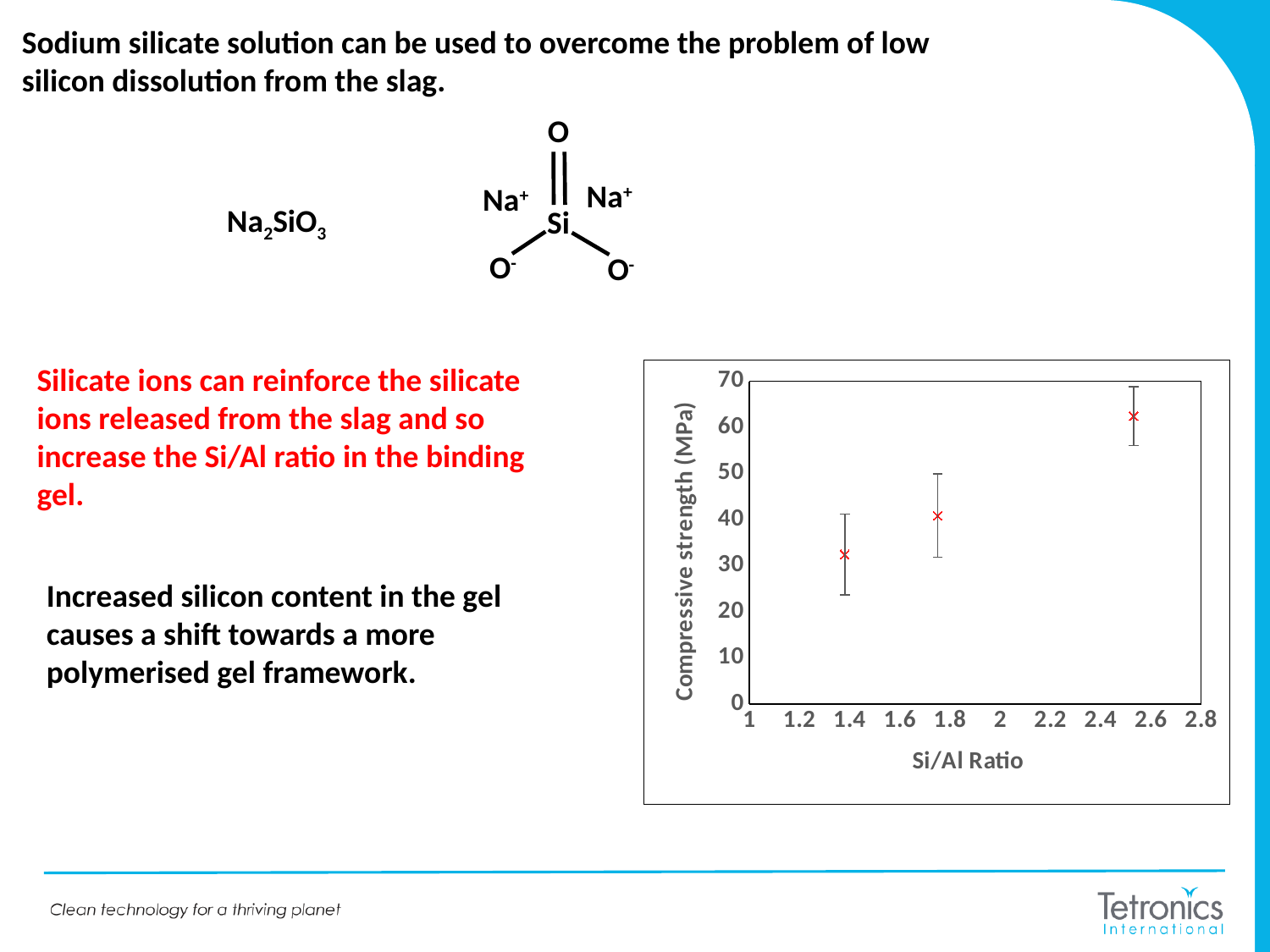
How many data points are plotted on the chart? 3 Is the compressive strength of the point with the highest Si/Al ratio greater or less than 70? less Which point has the highest compressive strength: the one with the lowest Si/Al ratio or the one with the highest Si/Al ratio? the one with the highest Si/Al ratio What is the maximum value shown on the y axis of the chart? 70 What is the title of the x axis of the chart? Si/Al Ratio Is the compressive strength of the middle point (Si/Al ratio between 1.6 and 1.8) greater or less than 50? less What kind of chart is shown on the slide? scatter plot Is the compressive strength of the point with the highest Si/Al ratio greater or less than 50? greater What is the title of the y axis of the chart? Compressive strength (MPa) Does compressive strength rise or fall as the Si/Al ratio increases along the x axis? rise